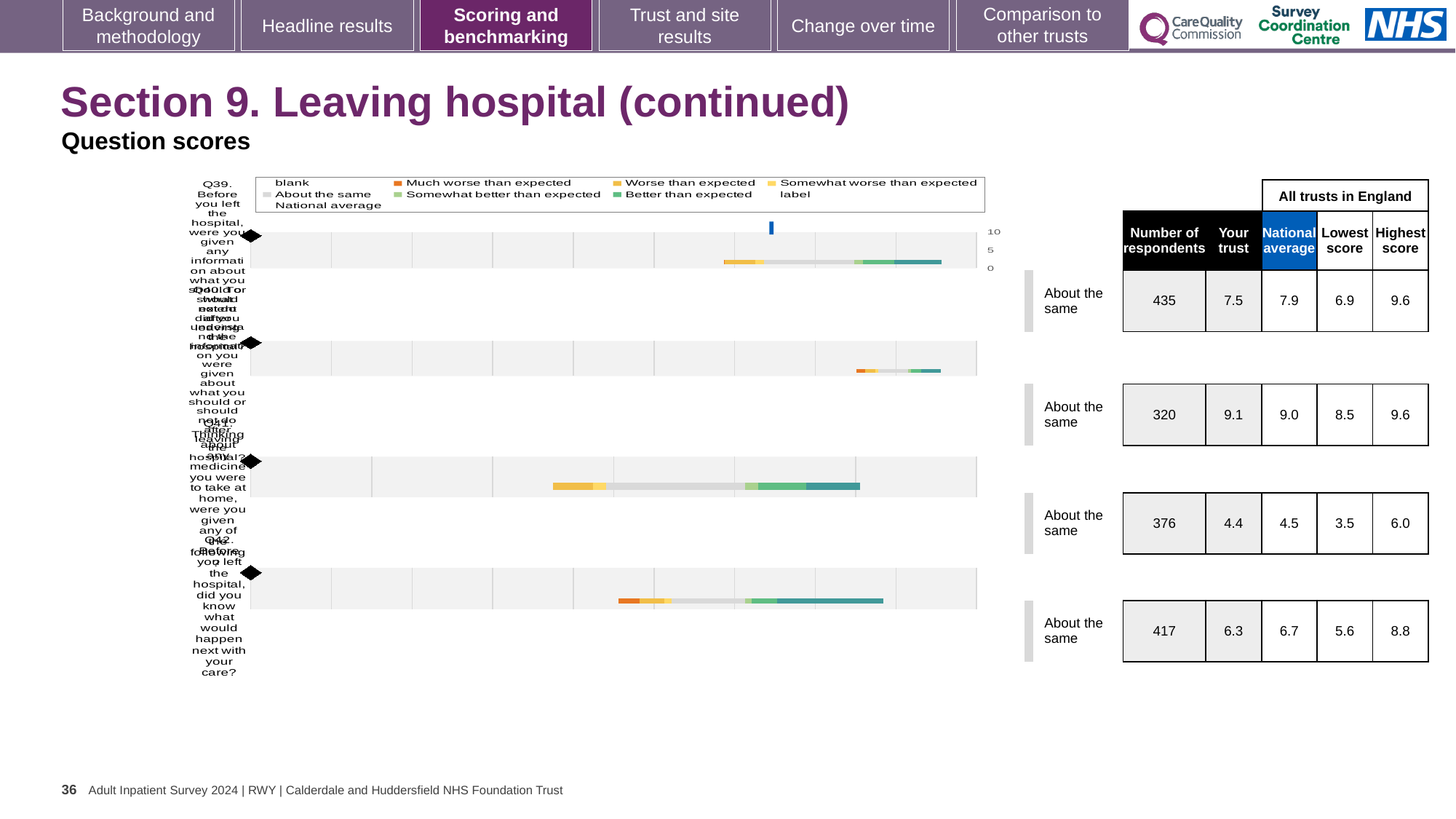
In the table beside the chart, what is the number of respondents for the second question row (Q40)? 320 In the table beside the chart, which question row has the lowest 'Your trust' score? Q41 (4.4) Which legend entry is shown in dark teal/green? Better than expected In the table beside the chart, what is the national average for the third question row (Q41)? 4.5 What kind of chart is shown on the slide? bar chart In the table beside the chart, is the 'Your trust' score for the second question row (Q40) larger or smaller than its national average? larger In the table beside the chart, what is the difference between the highest score and lowest score for the first question row (Q39)? 2.7 How many entries does the chart's legend list? 9 What colour does the legend use for 'Much worse than expected'? orange In the table beside the chart, what is the 'Your trust' score for the first question row (Q39)? 7.5 In the table beside the chart, what is the highest score for the fourth question row (Q42)? 8.8 How many question rows (bars) does the chart show? 4